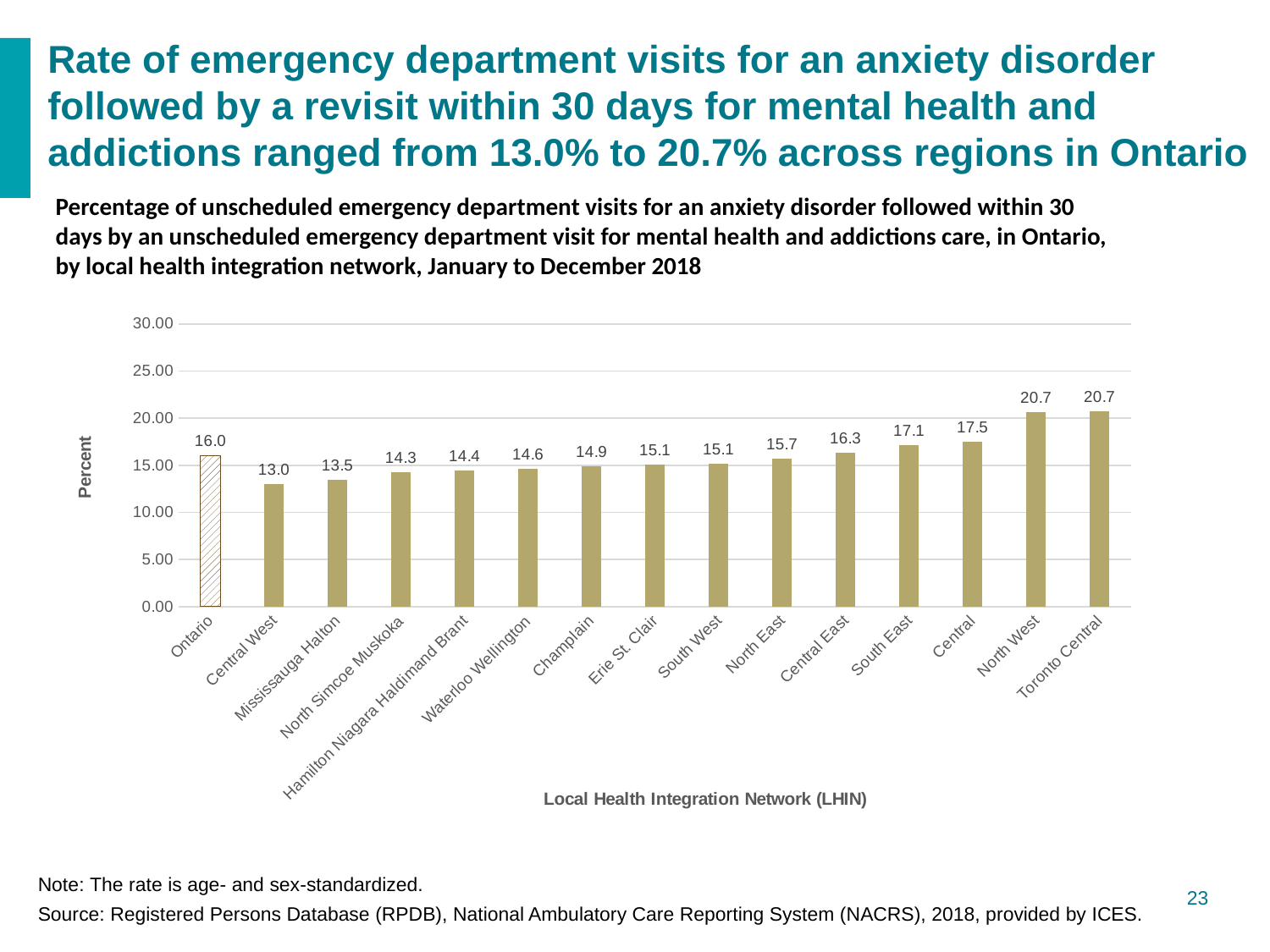
Is the value for North West greater or less than 20.00? greater Which has a larger value, North East or Mississauga Halton? North East What is the difference between the values for Toronto Central and Central West? 7.7 What is the difference between the values for Central and Ontario? 1.5 What is the value for Central East? 16.3 What is the value for Hamilton Niagara Haldimand Brant? 14.4 What is the highest value shown on the chart? 20.7 How many bars are shown on the chart? 15 What is the value for South East? 17.1 What is the value for Ontario? 16.0 What kind of chart is shown on the slide? Bar chart Which LHIN has the lowest value? Central West